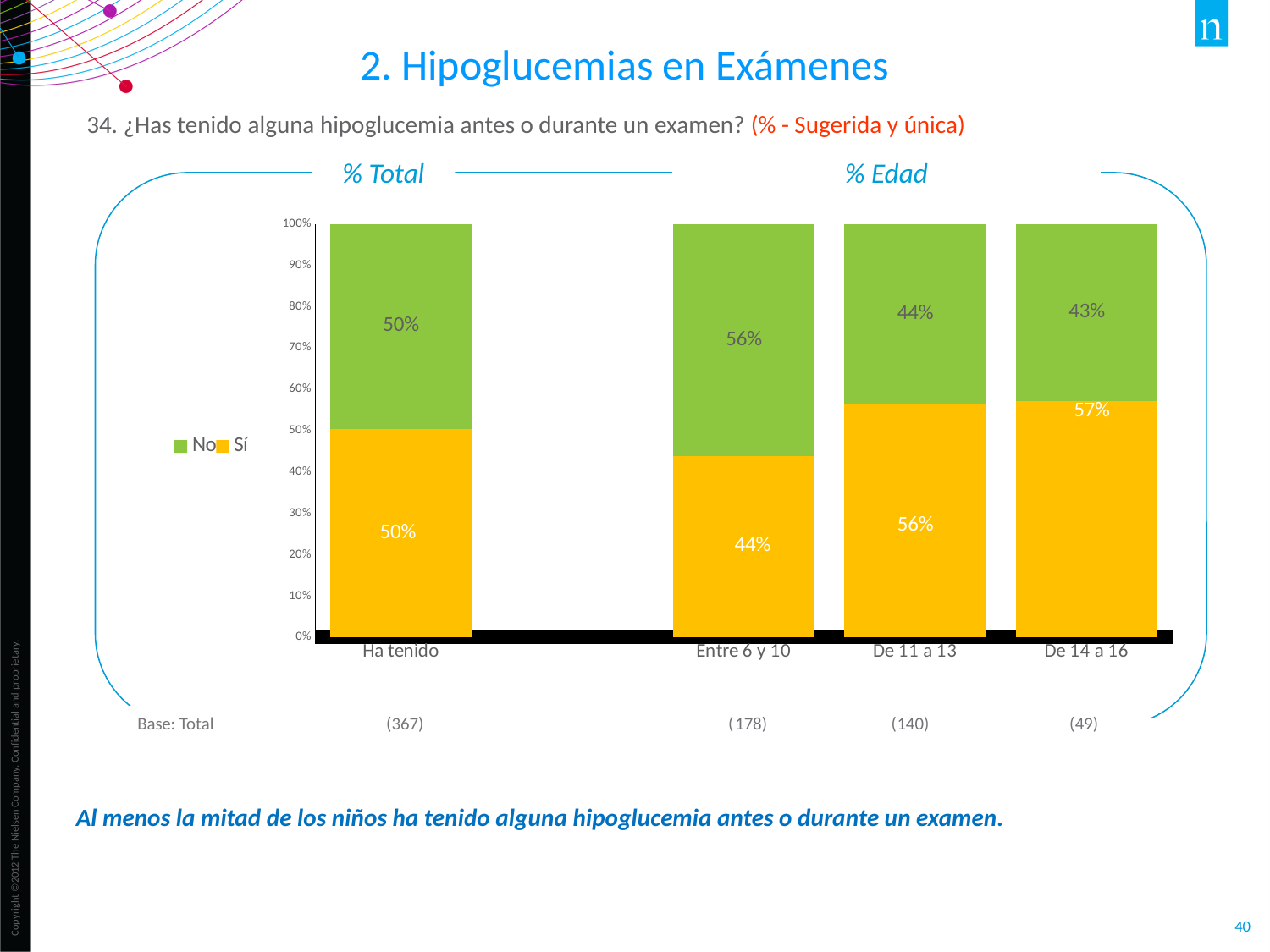
What is the value of the "No" series for "De 11 a 13"? 44% Which colour represents the "Sí" series in the chart? Yellow What is the difference between the "Sí" values for "De 11 a 13" and "Entre 6 y 10"? 12% Which category has the lowest value for the "Sí" series? Entre 6 y 10 What is the value of the "Sí" series for "Ha tenido"? 50% What is the value of the "No" series for "Entre 6 y 10"? 56% Which is larger: the "No" value for "Entre 6 y 10" or the "No" value for "De 14 a 16"? Entre 6 y 10 How many series does the legend list? 2 What is the value of the "Sí" series for "De 14 a 16"? 57% How many categories are shown on the x axis of the chart? 4 Which category has the highest value for the "Sí" series? De 14 a 16 What kind of chart is shown on the slide? Stacked bar chart